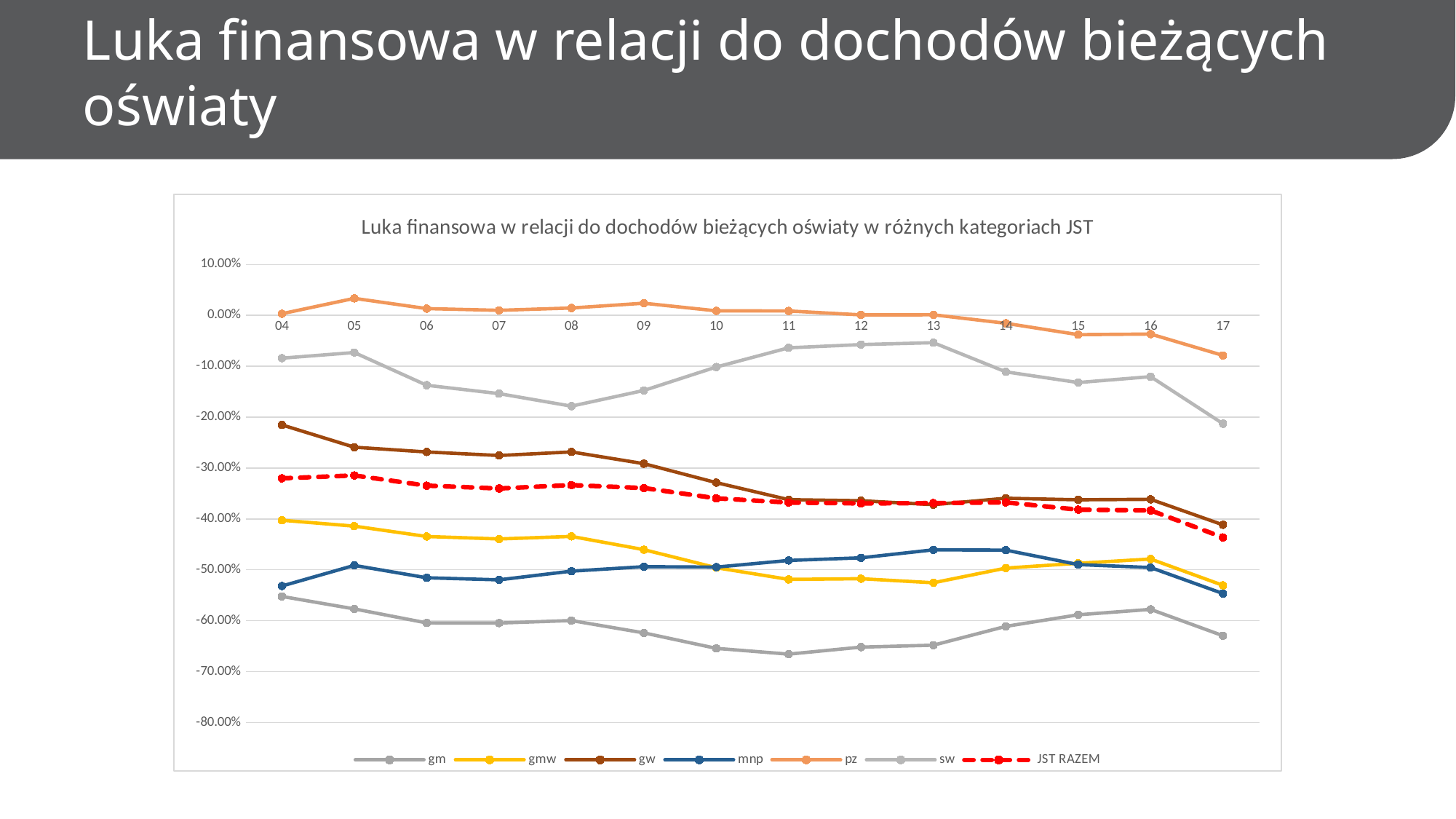
What type of chart is shown on the slide? line chart How many series does the legend list? 7 Which series is drawn with a dashed line? JST RAZEM Is the value for gw in 04 greater or less than -30.00%? greater Does the JST RAZEM line rise or fall from 04 to 17? fall Is the value for JST RAZEM in 17 greater or less than -40.00%? less Which series has the highest values across the chart? pz What is the title of the chart? Luka finansowa w relacji do dochodów bieżących oświaty w różnych kategoriach JST How many years are plotted along the x axis? 14 In 10, which series has the higher value, pz or gw? pz Is the value for pz in 17 greater or less than -10.00%? greater